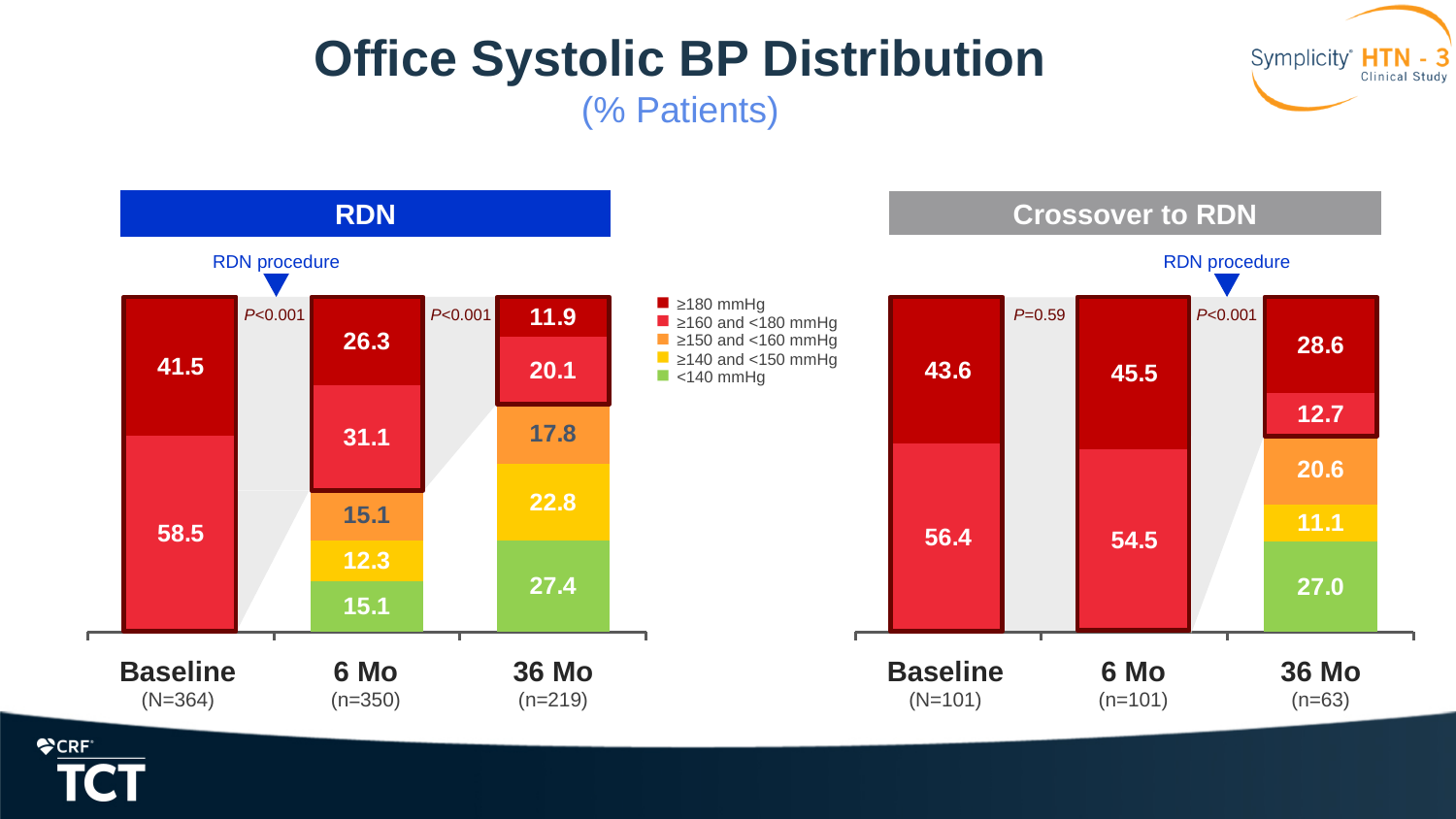
How many time points are shown in the Crossover to RDN chart? 3 What kind of chart is used on this slide? Stacked bar chart In the RDN chart, is the ≥160 and <180 mmHg percentage larger at 6 Mo or at 36 Mo? 6 Mo In the Crossover to RDN chart, which time point has the highest percentage of patients with office systolic BP ≥180 mmHg? 6 Mo How many series does the legend list? 5 In the RDN chart, what percentage of patients had office systolic BP ≥180 mmHg at Baseline? 41.5 In the Crossover to RDN chart, what percentage of patients had office systolic BP ≥140 and <150 mmHg at 36 Mo? 11.1 In the RDN chart, what percentage of patients had office systolic BP <140 mmHg at 36 Mo? 27.4 In the RDN chart, does the percentage of patients with office systolic BP ≥180 mmHg rise or fall from Baseline to 36 Mo? Fall In the Crossover to RDN chart, what percentage of patients had office systolic BP ≥180 mmHg at 6 Mo? 45.5 In the RDN chart, which time point has the lowest percentage of patients with office systolic BP ≥180 mmHg? 36 Mo In the RDN chart, what is the difference between the ≥180 mmHg percentage at Baseline and at 36 Mo? 29.6